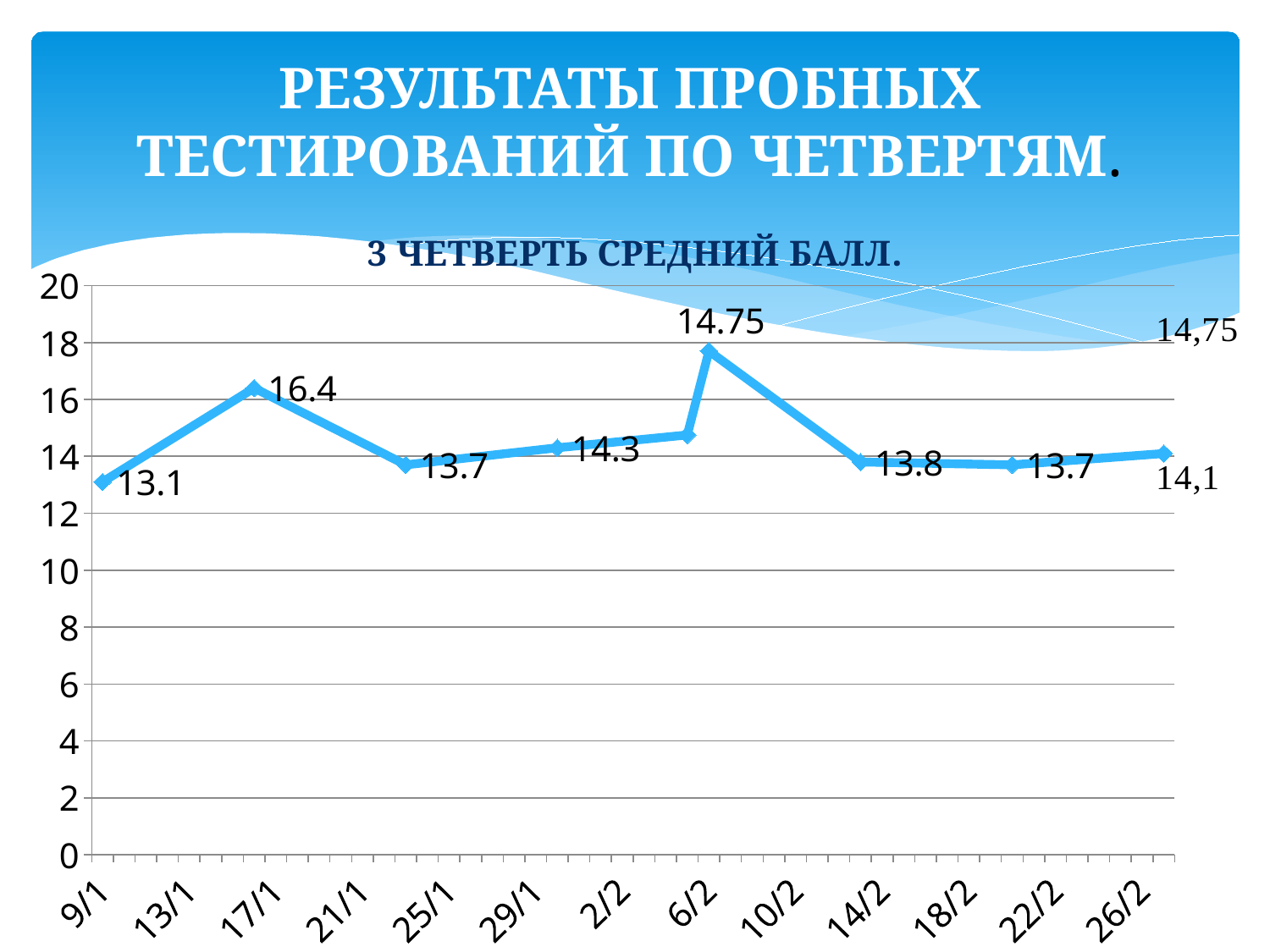
On which date is the value lowest? 9/1 Is the value plotted for 6/2 greater or less than 16? greater What kind of chart is shown? line chart What is the title of the chart? 3 ЧЕТВЕРТЬ СРЕДНИЙ БАЛЛ. On which date does the line reach its highest point? 6/2 What is the value for 9/1? 13.1